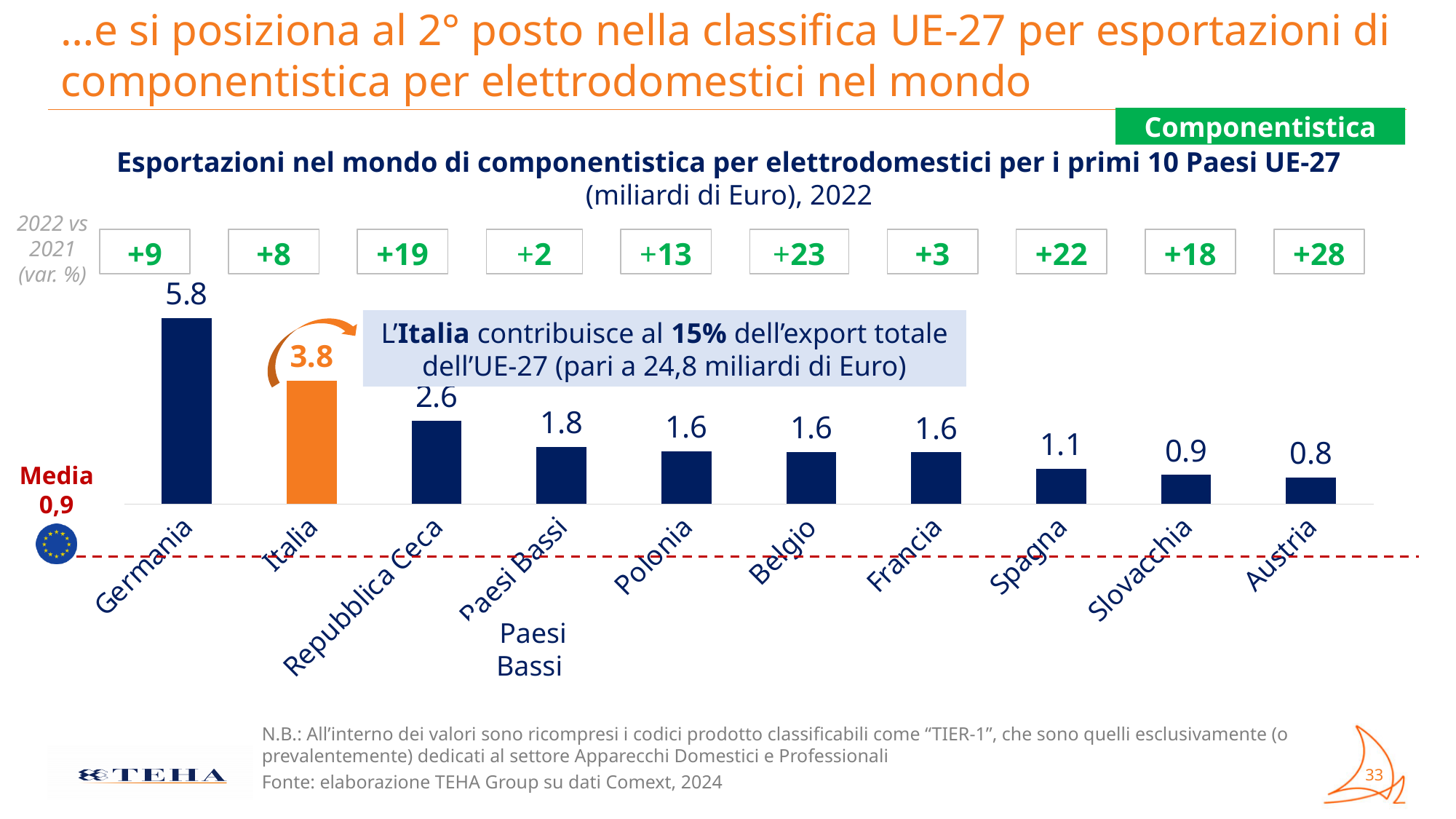
What is the value for Spagna? 1.1 Which country has the highest value? Germania What is the difference between the values for Germania and Italia? 2.0 What is the 2022 vs 2021 percentage variation shown above the bar for Austria? +28 What is the value for Repubblica Ceca? 2.6 What kind of chart is shown on the slide? Bar chart Which country has the lowest value? Austria How many countries are shown in the chart? 10 Do the values rise or fall from left to right across the countries? Fall What is the value for Germania? 5.8 What is the value for Italia? 3.8 Which is larger, the value for Paesi Bassi or the value for Slovacchia? Paesi Bassi